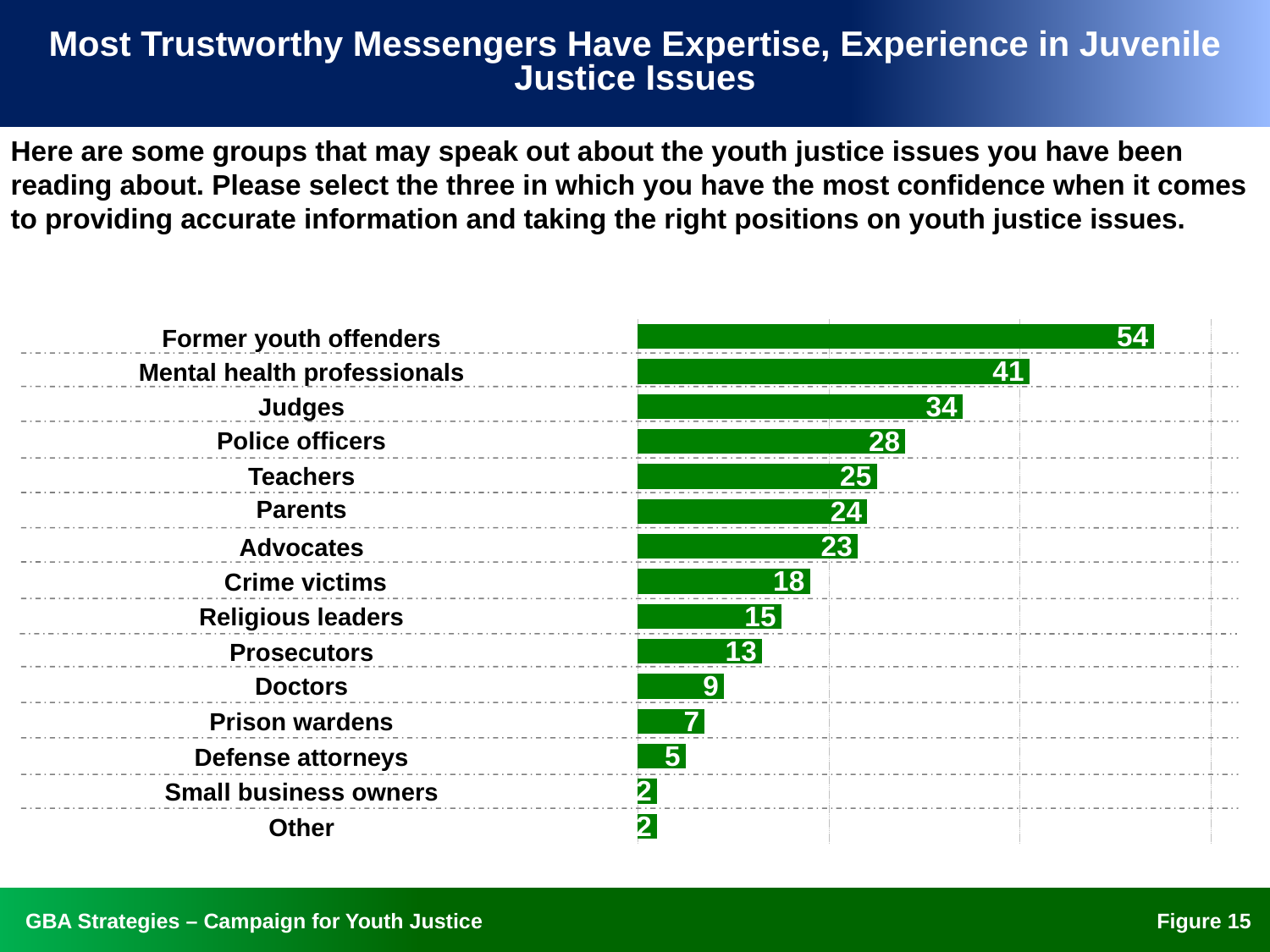
What is the value for Former youth offenders? 54 Which category has the highest value? Former youth offenders Which is larger, the value for Teachers or the value for Crime victims? Teachers What is the value for Judges? 34 What kind of chart is shown on the slide? Bar chart What is the difference between the values for Former youth offenders and Doctors? 45 What is the value for Prison wardens? 7 What colour are the bars in the chart? Green What is the difference between the values for Mental health professionals and Police officers? 13 What is the value for Religious leaders? 15 How many categories are shown in the chart? 15 Which is larger, the value for Prosecutors or the value for Defense attorneys? Prosecutors